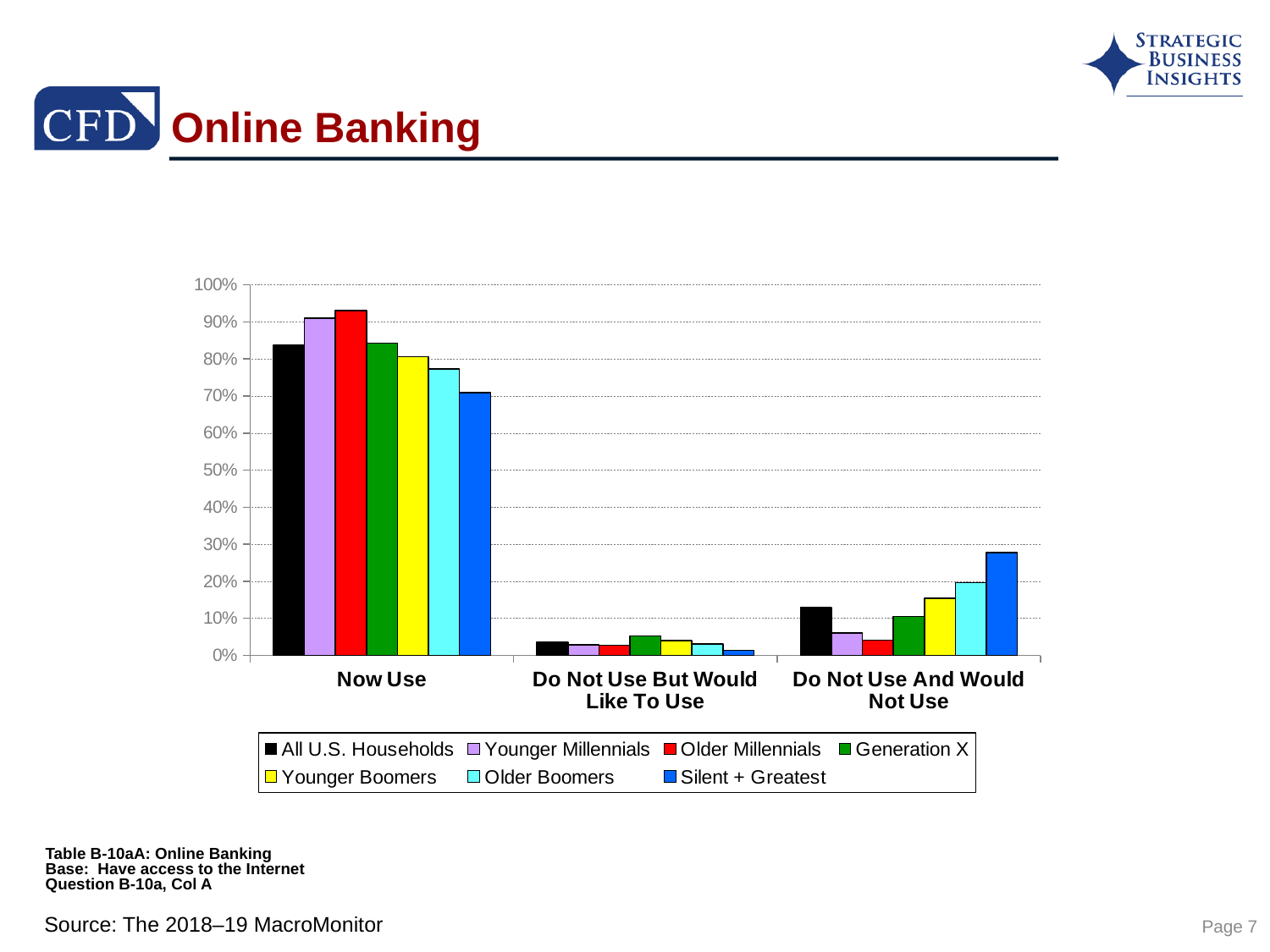
How many series does the legend list? 7 What is the source cited for the chart? The 2018–19 MacroMonitor In the Do Not Use And Would Not Use category, which series has the highest value? Silent + Greatest What kind of chart is shown on the slide? bar chart Is the Now Use value for Silent + Greatest greater or less than 80%? less In the Do Not Use And Would Not Use category, which is larger: Older Boomers or Younger Boomers? Older Boomers In the Now Use category, which series has the lowest value? Silent + Greatest Is the Now Use value for Younger Millennials greater or less than 80%? greater What colour represents Generation X in the legend? green Is the Do Not Use And Would Not Use value for All U.S. Households greater or less than 10%? greater How many categories are shown on the x axis? 3